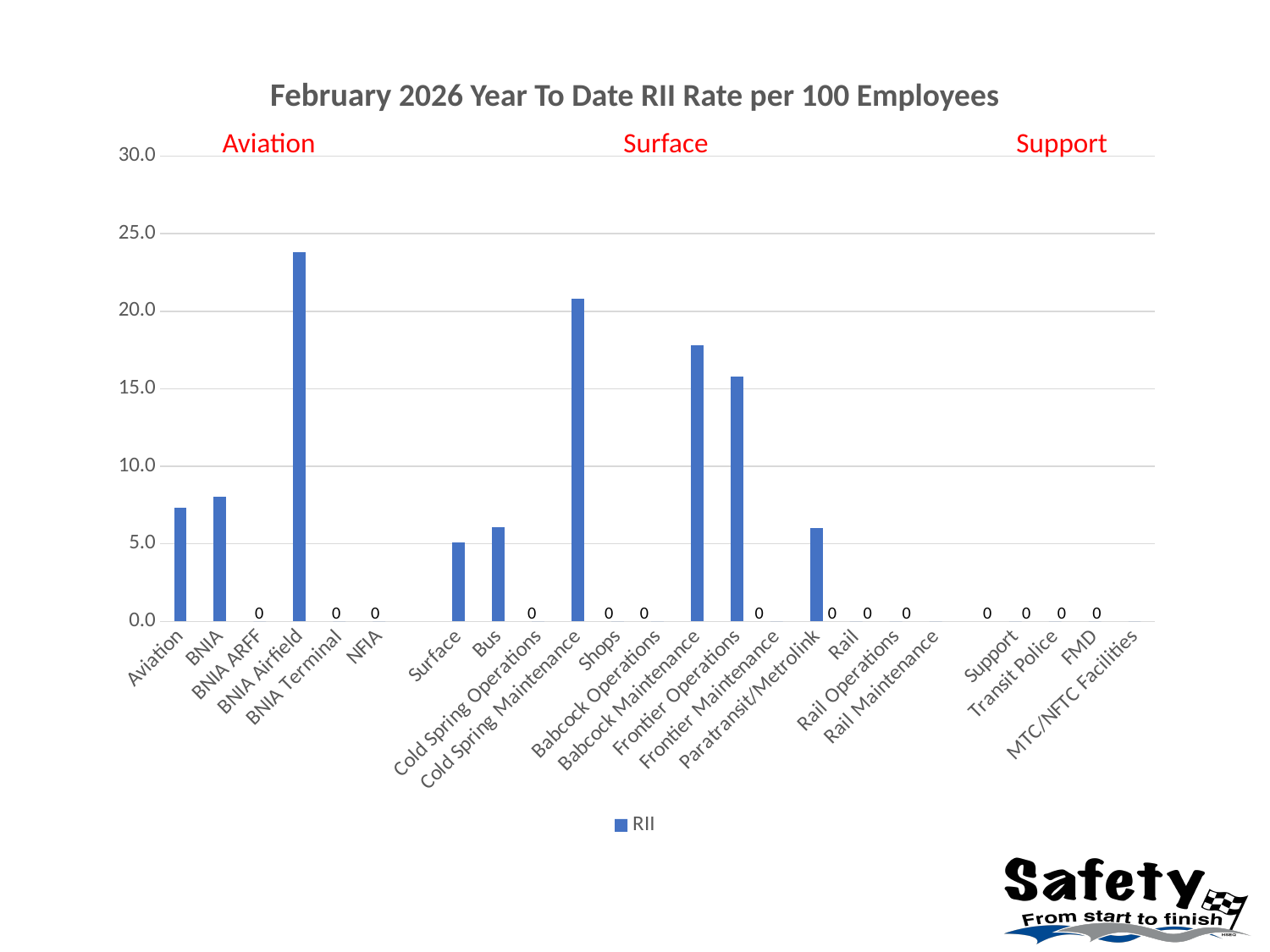
How many categories are shown on the x axis? 23 Is the value for Babcock Maintenance greater or less than 15.0? greater Is the value for BNIA Airfield greater or less than 20.0? greater What is the RII rate for Transit Police? 0 What is the title of the chart? February 2026 Year To Date RII Rate per 100 Employees Is the value for Frontier Operations greater or less than 20.0? less What is the RII rate for BNIA ARFF? 0 Which category has the highest RII rate? BNIA Airfield Which is larger, the value for BNIA Airfield or the value for Cold Spring Maintenance? BNIA Airfield What kind of chart is shown on the slide? bar chart How many series does the legend list? 1